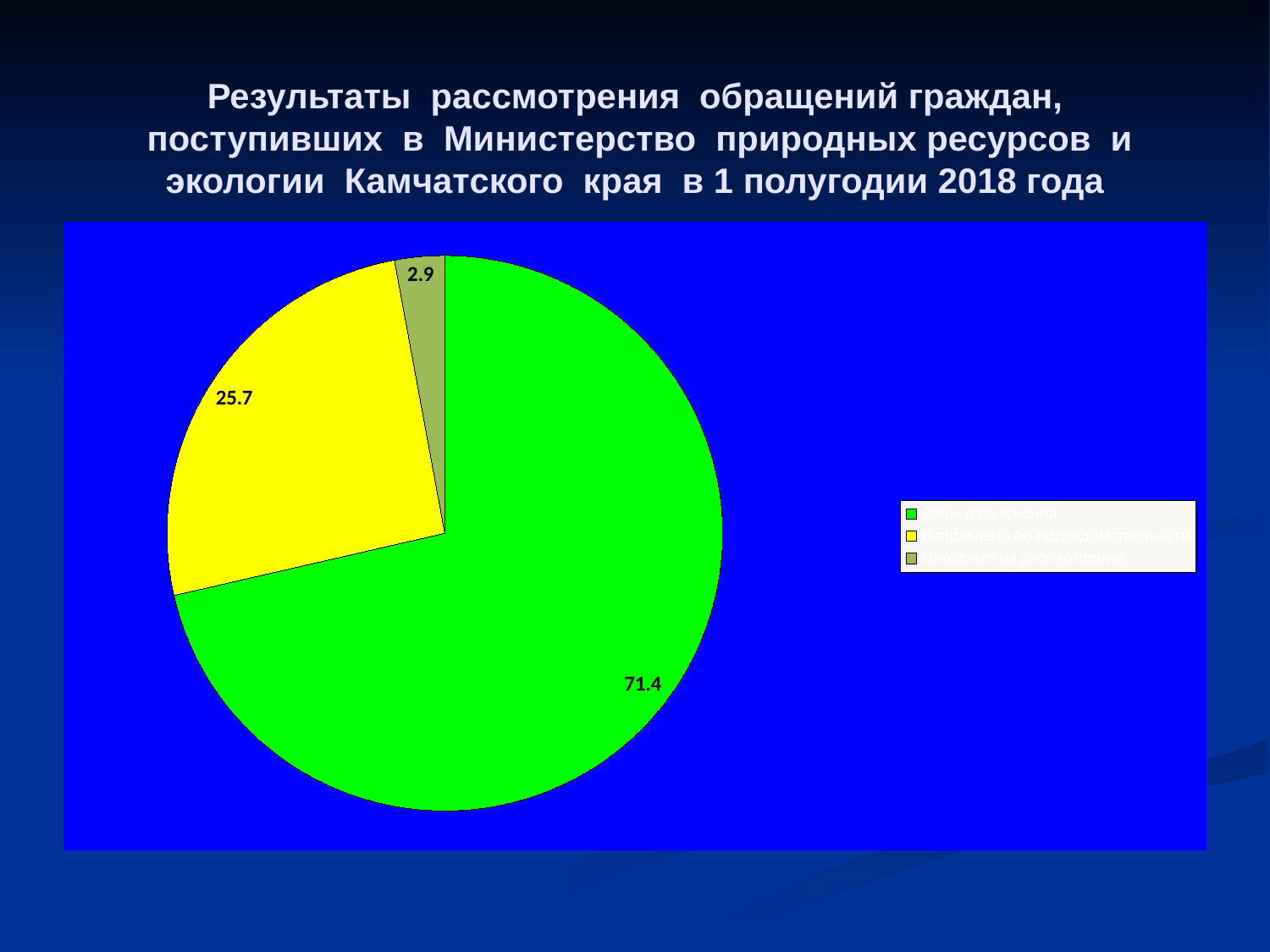
Which is larger, the yellow slice or the olive green slice? yellow What is the difference between the green slice value and the yellow slice value? 45.7 How many slices does the pie chart have? 3 What colour is the background of the chart area? blue What value is shown on the green slice of the pie chart? 71.4 Which colour slice is the smallest in the pie chart? olive green (grey-green) What value is shown on the smallest slice of the pie chart? 2.9 What value is shown on the yellow slice of the pie chart? 25.7 What kind of chart is shown on the slide? pie chart What is the total of the three values shown on the pie chart? 100 How many entries does the legend of the pie chart list? 3 Which colour slice is the largest in the pie chart? green